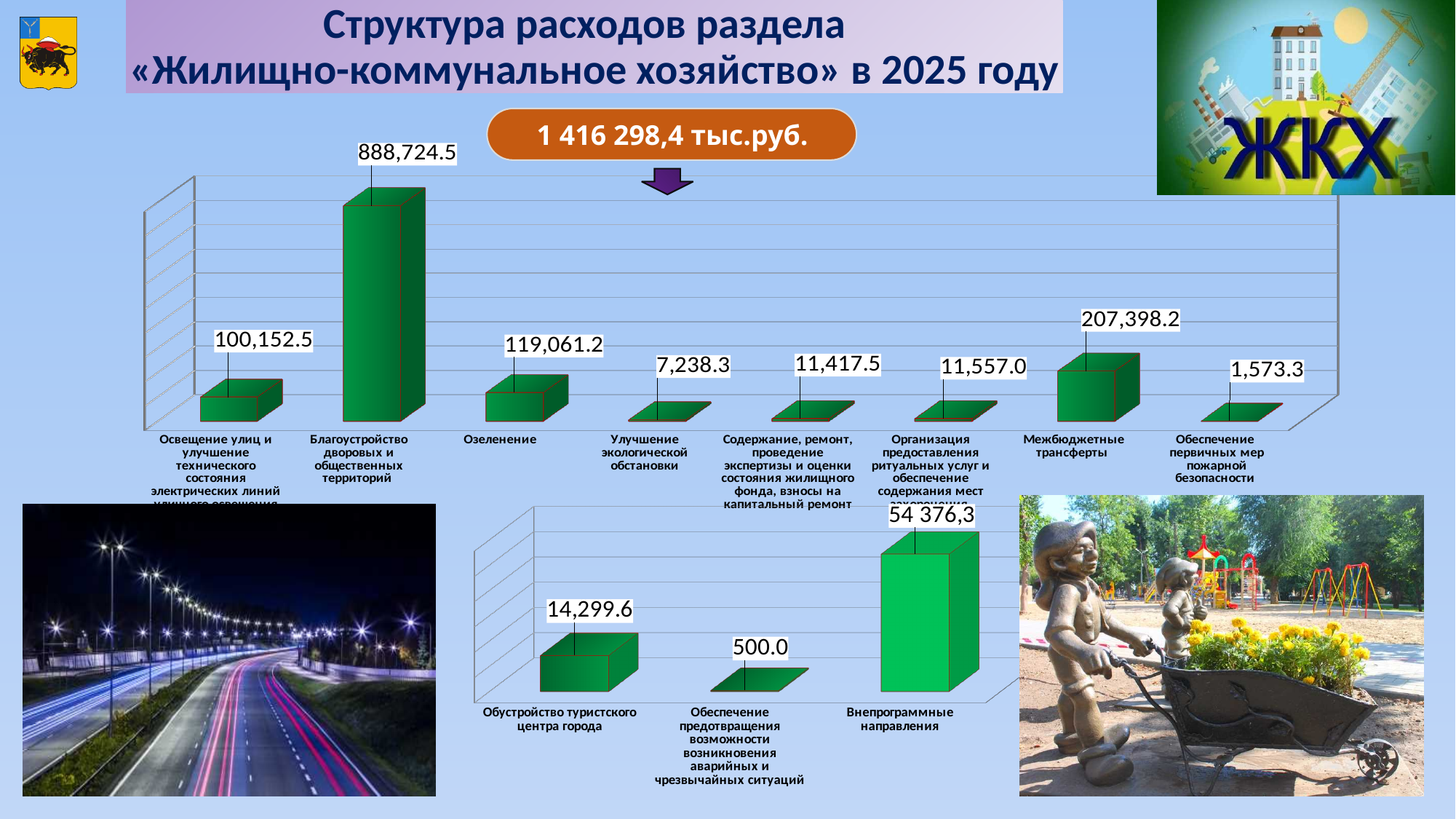
In the upper chart, what is the value for Улучшение экологической обстановки? 7,238.3 In the lower chart, what is the difference between Обустройство туристского центра города and Обеспечение предотвращения возможности возникновения аварийных и чрезвычайных ситуаций? 13,799.6 What kind of chart is the lower chart? Bar chart In the upper chart, which category has the highest value? Благоустройство дворовых и общественных территорий In the upper chart, what is the difference between Благоустройство дворовых и общественных территорий and Межбюджетные трансферты? 681,326.3 In the upper chart, what is the value for Благоустройство дворовых и общественных территорий? 888,724.5 In the lower chart, what is the value for Внепрограммные направления? 54 376,3 In the upper chart, which category has the lowest value? Обеспечение первичных мер пожарной безопасности How many categories are shown in the upper chart? 8 What total amount is shown in the orange box above the upper chart? 1 416 298,4 тыс.руб. In the upper chart, which is larger: Озеленение or Освещение улиц и улучшение технического состояния электрических линий уличного освещения? Озеленение In the upper chart, what is the value for Межбюджетные трансферты? 207,398.2